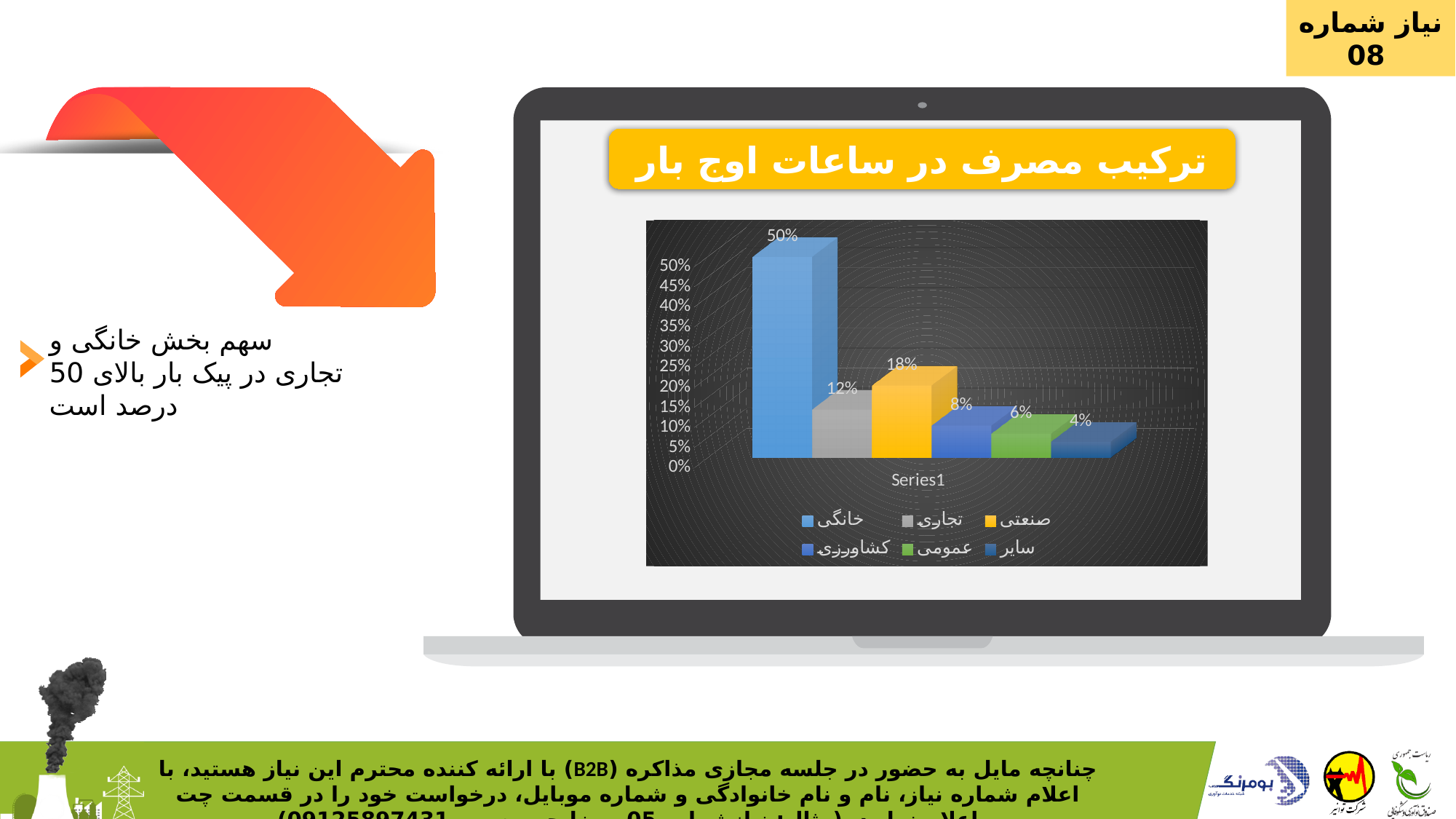
What is the difference between the values for خانگی and صنعتی? 32% What is the value for تجاری in the chart? 12% What is the title of the chart? ترکیب مصرف در ساعات اوج بار What is the value for خانگی in the chart? 50% What kind of chart is shown on the slide? bar chart Which is larger, the value for تجاری or the value for صنعتی? صنعتی What is the value for سایر in the chart? 4% How many series does the legend list? 6 Is the value for کشاورزی greater or less than 10%? less Which category has the lowest value in the chart? سایر Which category has the highest value in the chart? خانگی What is the value for صنعتی in the chart? 18%